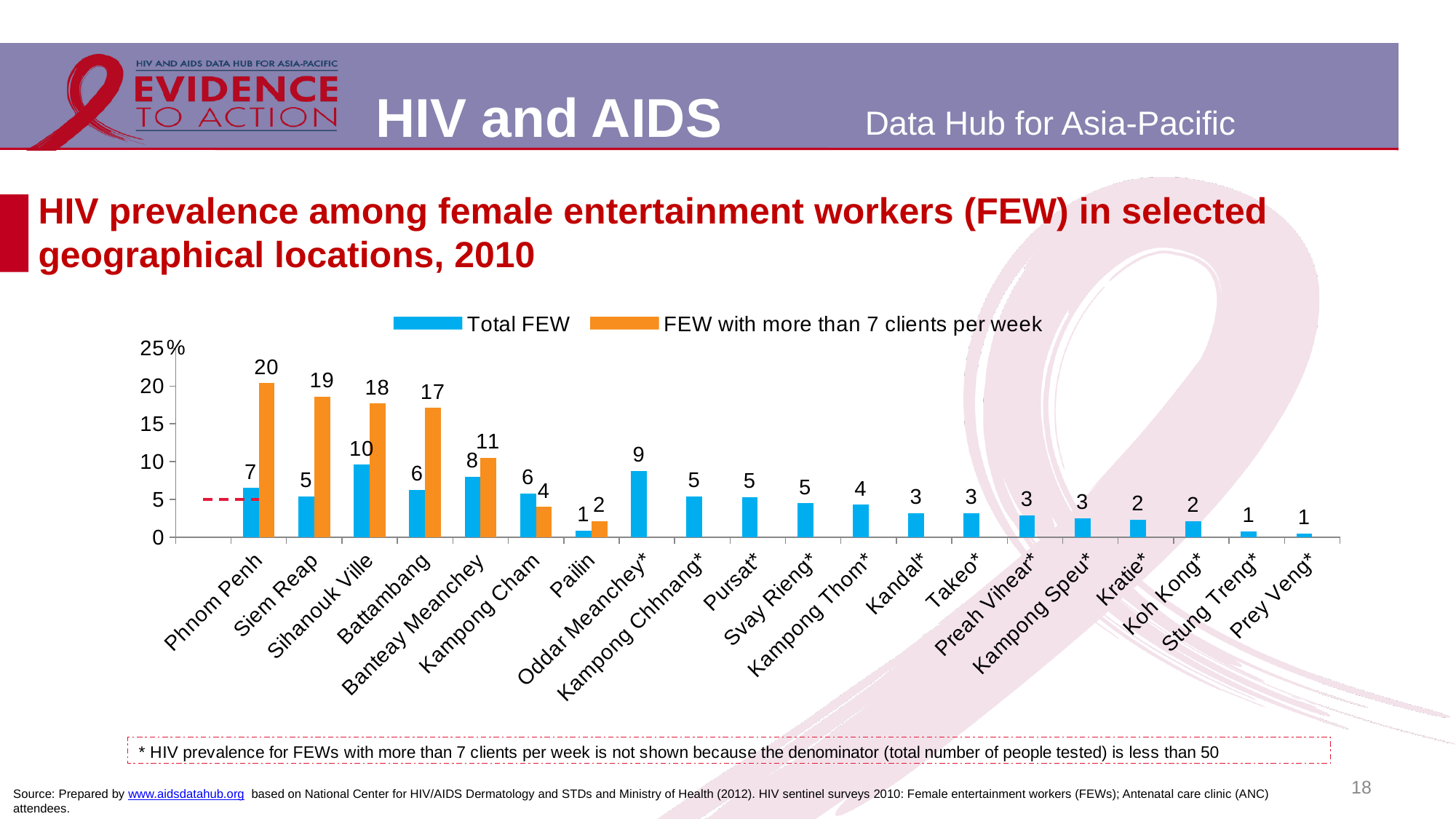
How many geographical locations are shown on the x axis? 20 What is the Total FEW value for Sihanouk Ville? 10 How many series does the legend list? 2 Which location has the lowest value for FEW with more than 7 clients per week? Pailin What colour represents the Total FEW series in the legend? Blue In Kampong Cham, which is larger: Total FEW or FEW with more than 7 clients per week? Total FEW What is the difference between the FEW with more than 7 clients per week value and the Total FEW value for Phnom Penh? 13 What kind of chart is shown on the slide? Bar chart What is the value for FEW with more than 7 clients per week in Phnom Penh? 20 Which location has the highest Total FEW value? Sihanouk Ville Which location has the highest value for FEW with more than 7 clients per week? Phnom Penh What is the value for FEW with more than 7 clients per week in Banteay Meanchey? 11